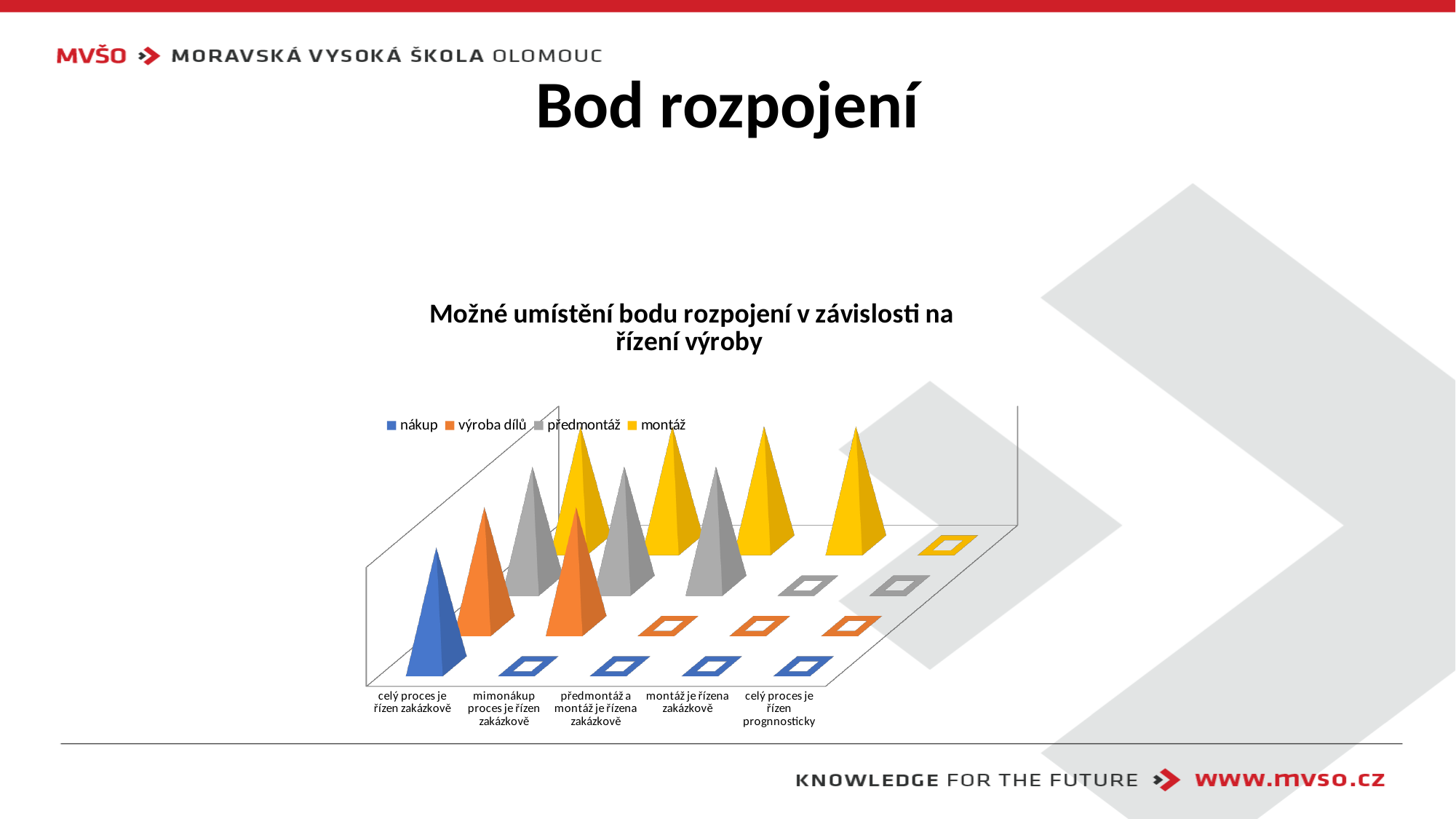
How many categories are shown along the x axis of the chart? 5 For the category 'montáž je řízena zakázkově', which series have visible bars? montáž Which category is the only one where the 'nákup' series has a visible bar? celý proces je řízen zakázkově What is the title of the chart? Možné umístění bodu rozpojení v závislosti na řízení výroby How many series does the chart legend list? 4 Does the 'montáž' series have a visible bar in every category? no For the category 'celý proces je řízen zakázkově', how many series have a visible bar? 4 What kind of chart is shown on the slide? bar chart Which series are listed in the chart legend? nákup, výroba dílů, předmontáž, montáž